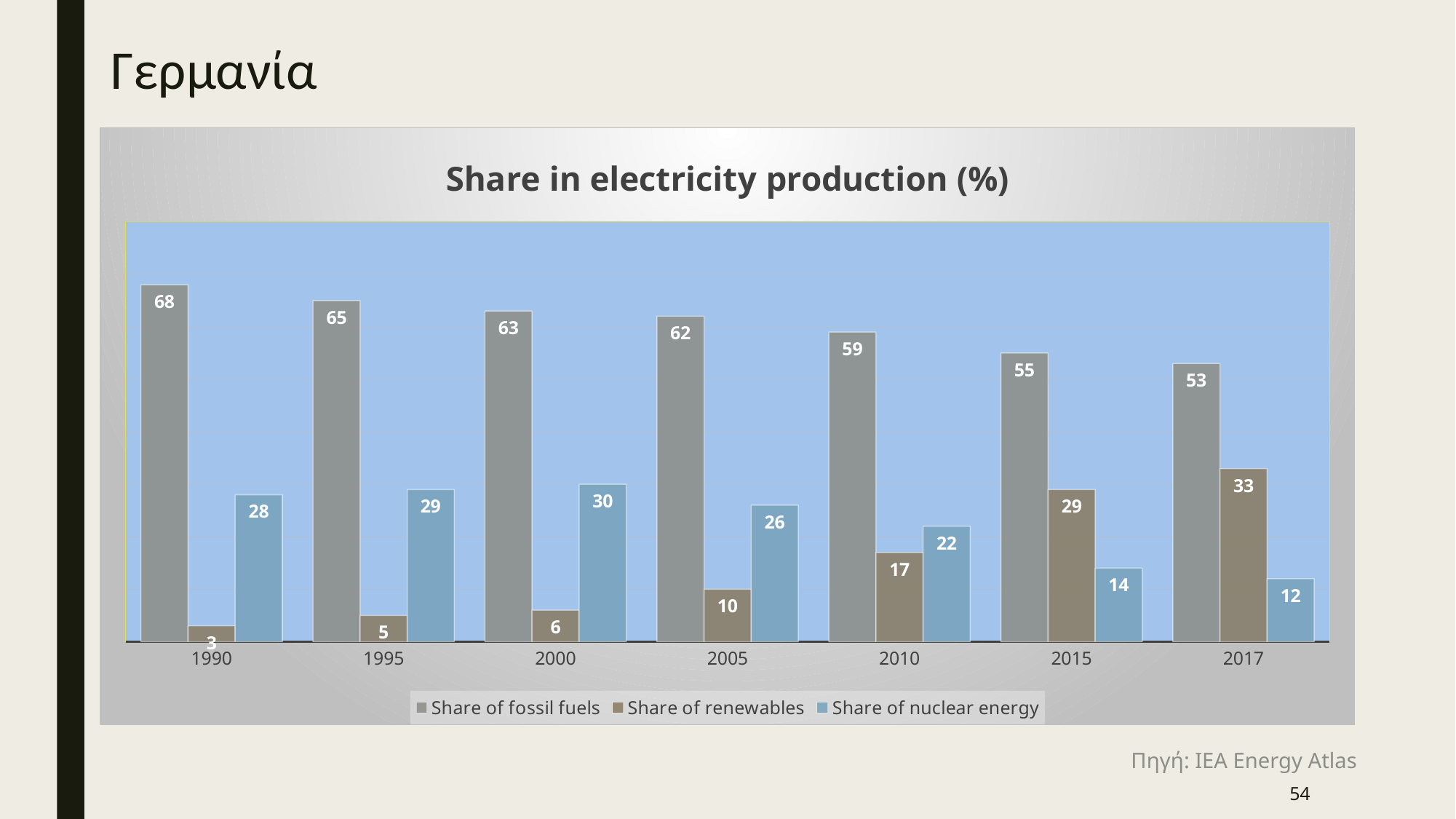
What kind of chart is shown on the slide? Bar chart What is the difference between the share of fossil fuels in 1990 and in 2017? 15 How many years are shown on the x axis? 7 Does the share of fossil fuels rise or fall from 1990 to 2017? Fall What is the share of fossil fuels in 1990? 68 In which year is the share of nuclear energy highest? 2000 Which is larger in 2015: the share of renewables or the share of nuclear energy? Share of renewables How many series does the legend list? 3 In which year is the share of renewables lowest? 1990 What is the share of renewables in 2017? 33 What is the share of nuclear energy in 2005? 26 What is the title of the chart? Share in electricity production (%)